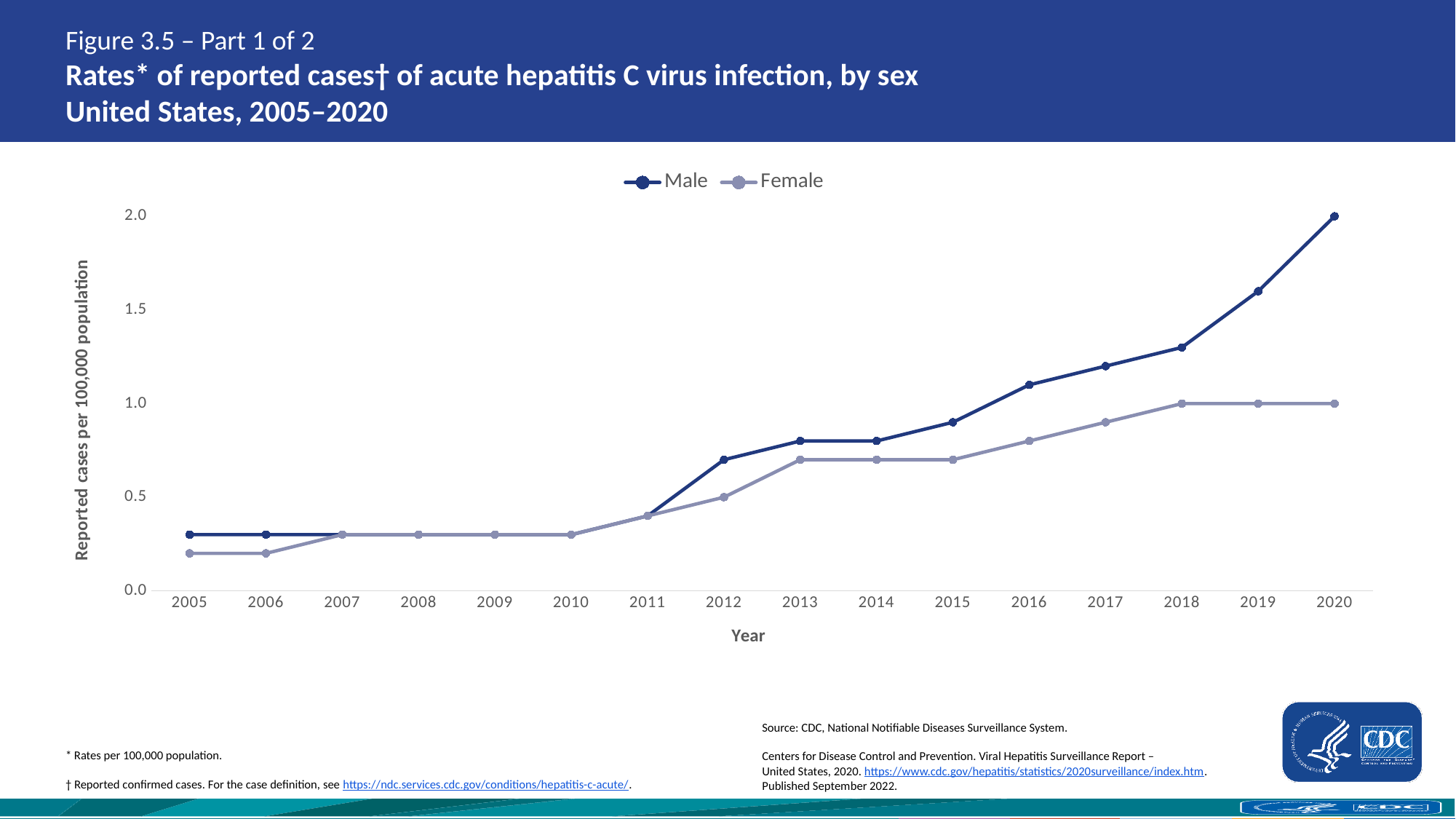
In which year is the Male rate highest? 2020 In 2020, which series has the higher rate, Male or Female? Male What is the label on the y axis? Reported cases per 100,000 population Is the Male value for 2016 greater or less than 1.0? greater Is the Female value for 2005 greater or less than 0.5? less What is the Female rate in 2018? 1.0 What is the Female rate in 2012? 0.5 Is the Male value for 2019 greater or less than 1.5? greater What kind of chart is shown on the slide? line chart Do the Male rates rise or fall from 2010 to 2020? rise How many years are plotted along the x axis? 16 How many series does the legend list? 2